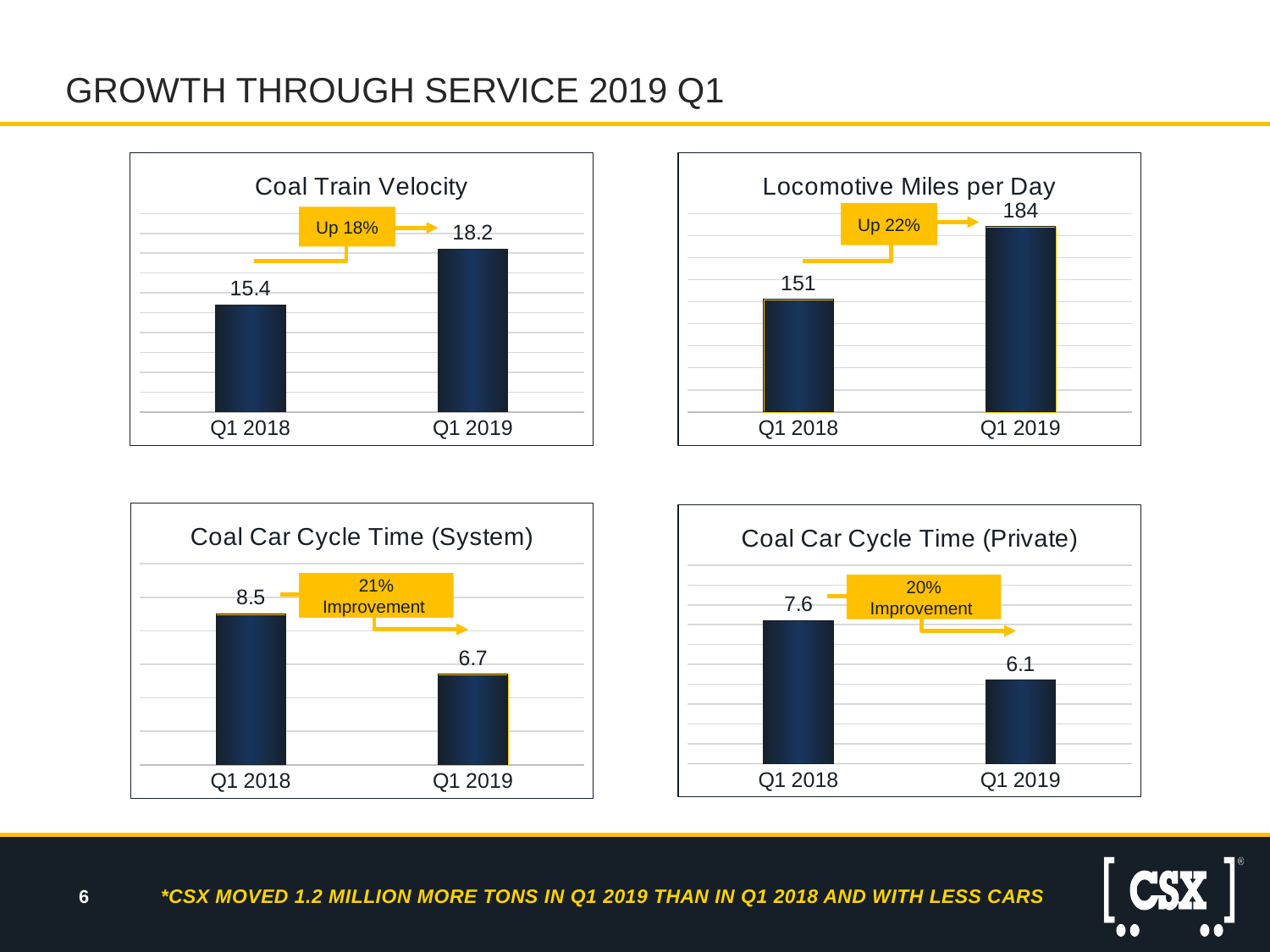
In the Coal Car Cycle Time (Private) chart, what is the difference between the Q1 2018 and Q1 2019 values? 1.5 In the Coal Train Velocity chart, which quarter has the higher value? Q1 2019 In the Coal Car Cycle Time (Private) chart, what is the value for Q1 2019? 6.1 In the Coal Train Velocity chart, what is the value for Q1 2018? 15.4 In the Coal Car Cycle Time (System) chart, which quarter has the lower value? Q1 2019 In the Locomotive Miles per Day chart, what percentage increase does the callout label show? Up 22% In the Coal Car Cycle Time (System) chart, what is the value for Q1 2018? 8.5 In the Locomotive Miles per Day chart, what is the value for Q1 2019? 184 How many categories are shown on the x axis of the Coal Car Cycle Time (System) chart? 2 In the Locomotive Miles per Day chart, what is the difference between the Q1 2019 and Q1 2018 values? 33 In the Coal Train Velocity chart, what is the value for Q1 2019? 18.2 What kind of chart is the Locomotive Miles per Day chart? Bar chart